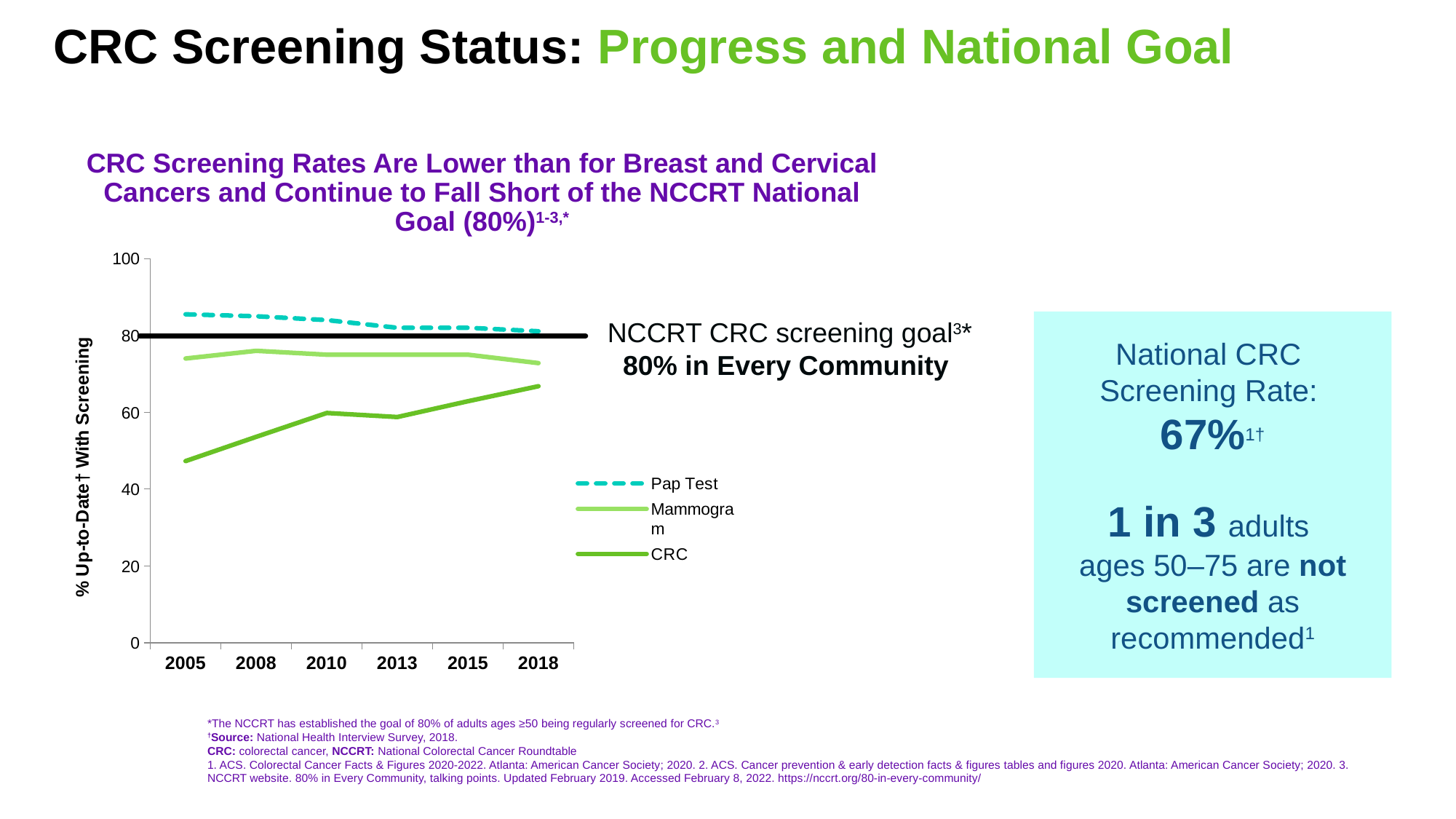
In 2005, which is larger: the Pap Test rate or the CRC rate? Pap Test How many years are shown along the x axis of the chart? 6 Does the Pap Test screening rate rise or fall from 2005 to 2018? fall What does the horizontal black line on the chart represent? NCCRT CRC screening goal of 80% in Every Community Does the CRC screening rate rise or fall from 2005 to 2018? rise Is the Mammogram value for 2018 greater or less than 80? less Is the CRC value for 2005 greater or less than 60? less Is the Pap Test value for 2005 greater or less than 80? greater Which series has the lowest value in 2018? CRC What kind of chart is shown on the slide? line chart How many series does the chart's legend list? 3 Which series has the highest value in 2005? Pap Test